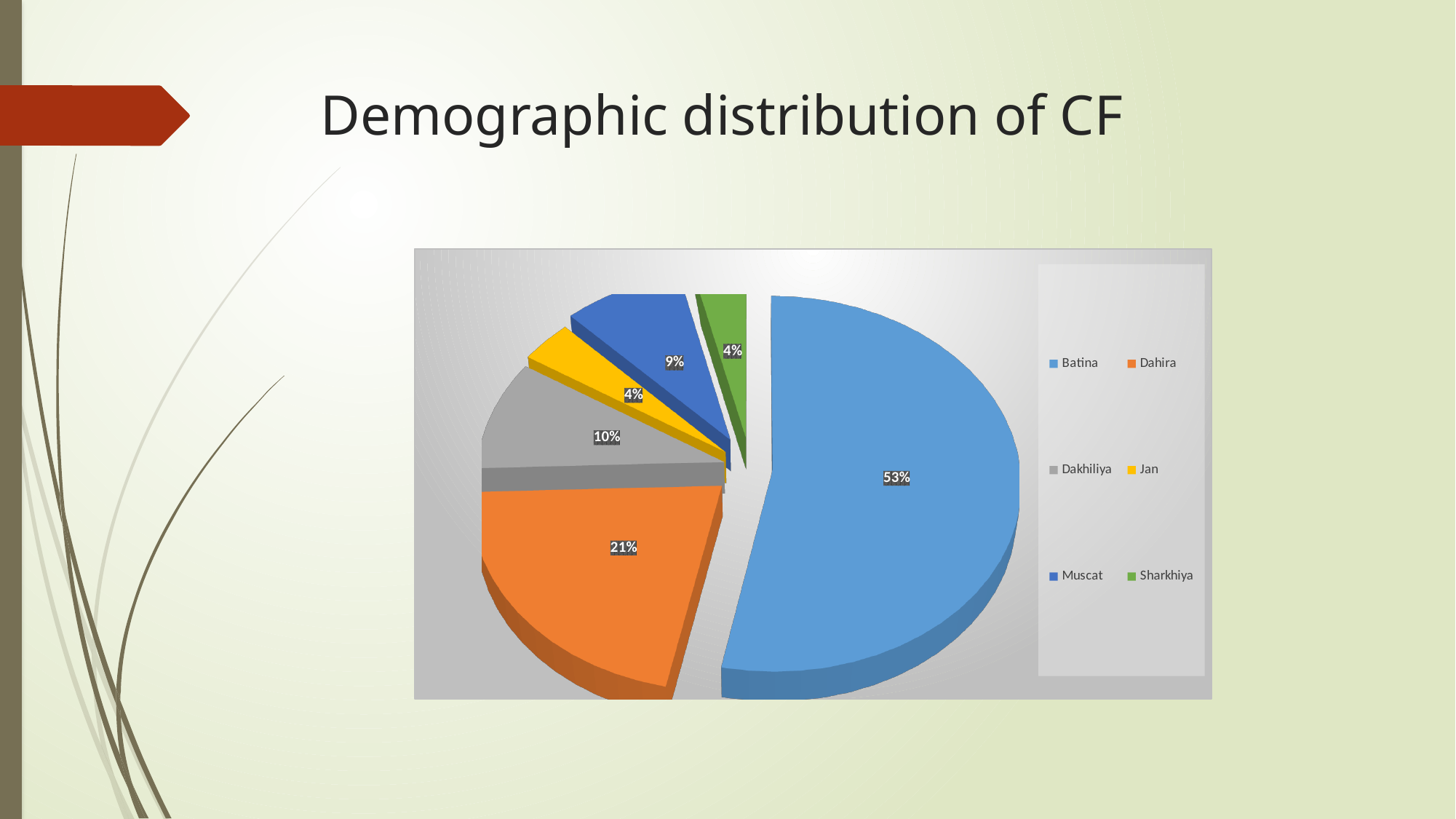
What kind of chart is shown on the slide? pie chart Which is larger, the share for Dakhiliya or the share for Muscat? Dakhiliya What share of the pie does Batina have? 53% Which region has the largest slice of the pie? Batina What share of the pie does Muscat have? 9% What share of the pie does Dakhiliya have? 10% How many slices does the pie chart have? 6 What is the title of the slide containing the chart? Demographic distribution of CF What is the difference in percentage points between Batina and Dahira? 32 How many entries does the legend list? 6 What share of the pie does Dahira have? 21% What share of the pie does Jan have? 4%